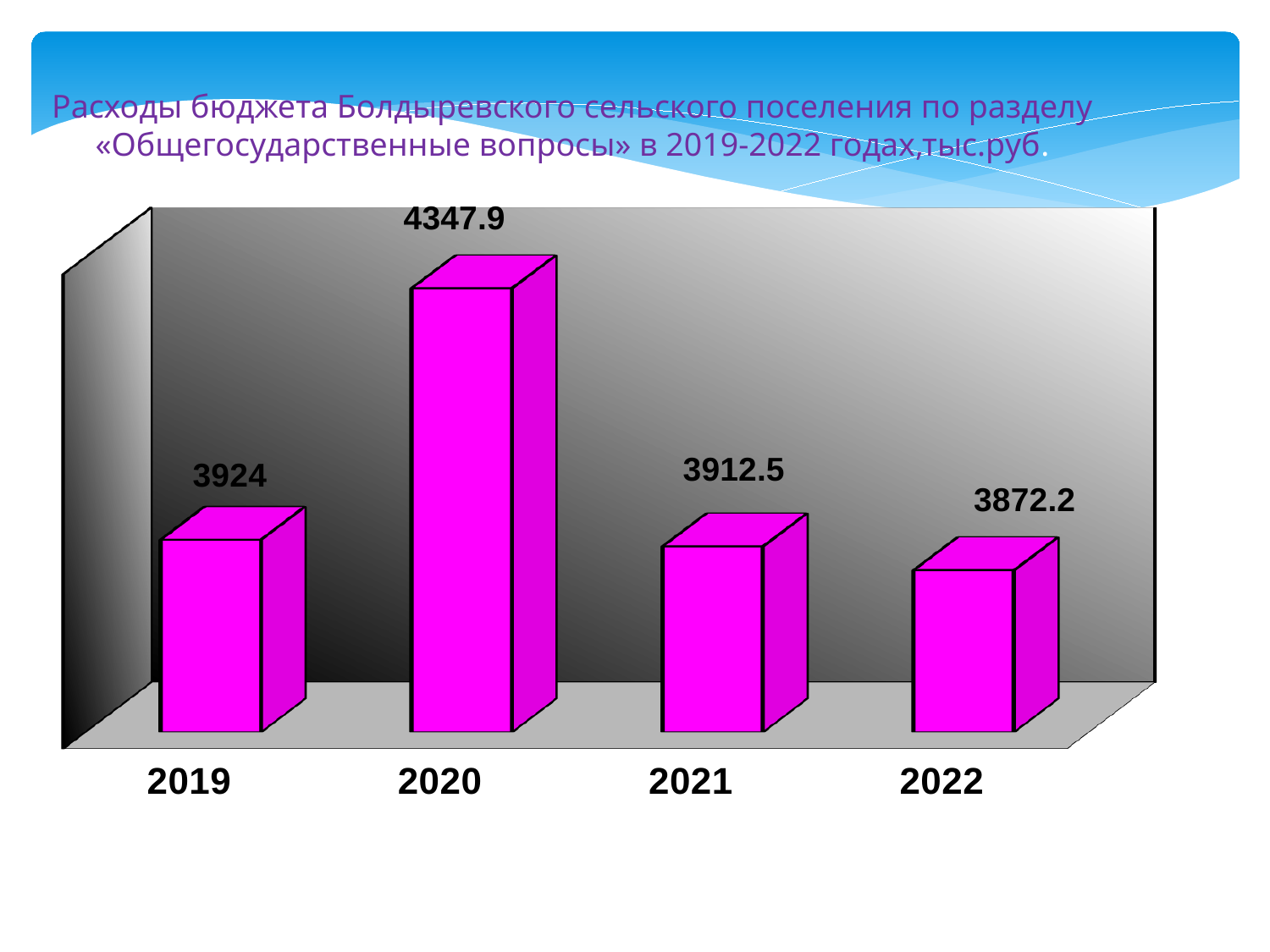
What is the value for 2022? 3872.2 What is the value for 2019? 3924 What kind of chart is shown on the slide? bar chart Which is larger, the value for 2019 or the value for 2021? 2019 Which year has the lowest value? 2022 What is the value for 2021? 3912.5 What is the difference between the values for 2021 and 2022? 40.3 Which year has the highest value? 2020 What is the value for 2020? 4347.9 Do the values rise or fall from 2020 to 2022? fall What is the difference between the values for 2020 and 2019? 423.9 How many years are shown on the chart? 4